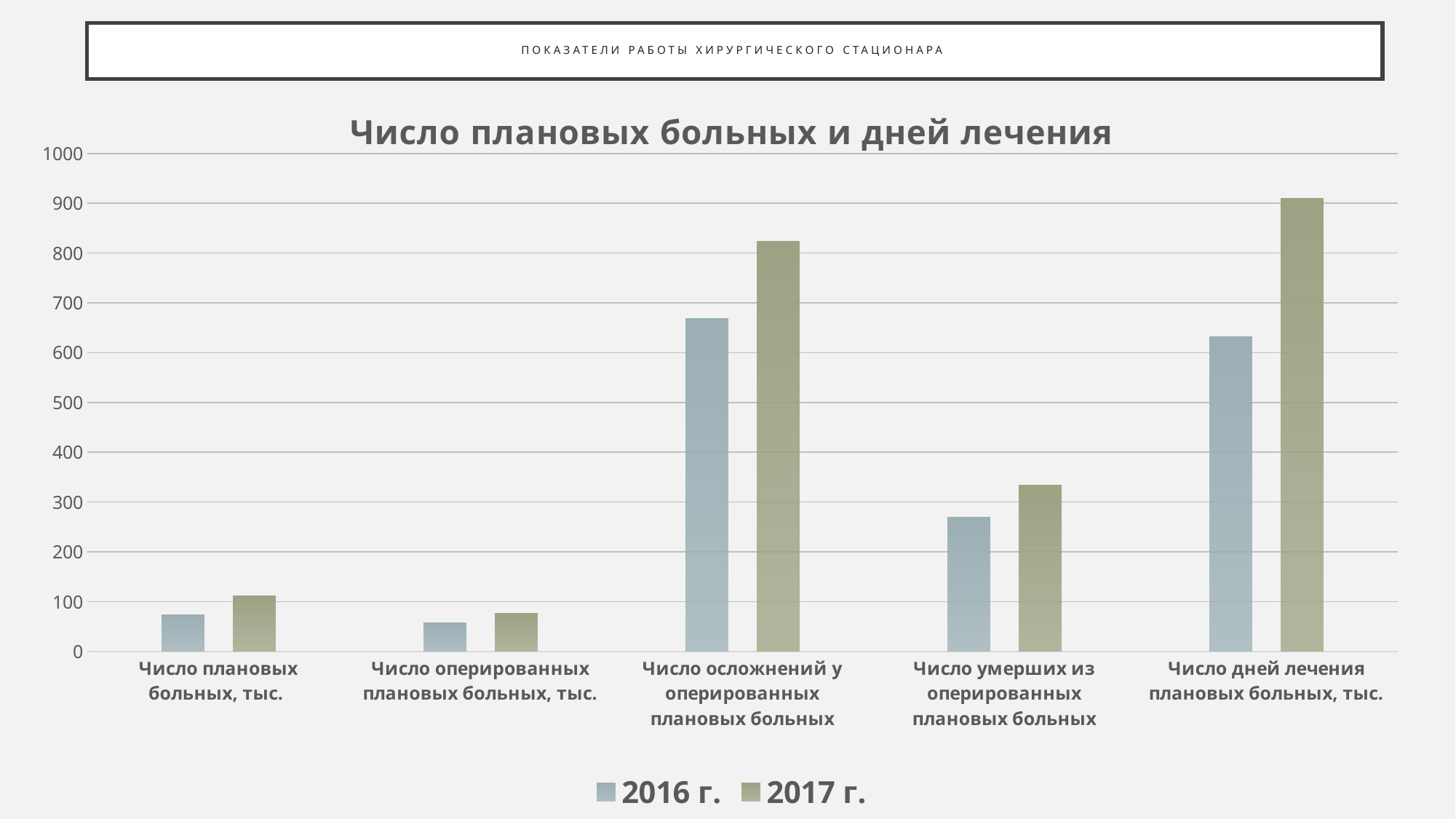
Which is larger for Число осложнений у оперированных плановых больных: the value for 2016 г. or for 2017 г.? 2017 г. Which category has the highest value for 2017 г.? Число дней лечения плановых больных, тыс. What kind of chart is shown on the slide? bar chart Is the value for Число осложнений у оперированных плановых больных in 2016 г. greater or less than 600? greater Which category has the lowest value for 2016 г.? Число оперированных плановых больных, тыс. How many series does the legend list? 2 Is the value for Число дней лечения плановых больных, тыс. in 2017 г. greater or less than 800? greater How many categories are shown on the x axis? 5 Which is larger for Число плановых больных, тыс.: the value for 2016 г. or for 2017 г.? 2017 г. What is the title of the chart? Число плановых больных и дней лечения Which category has the lowest value for 2017 г.? Число оперированных плановых больных, тыс. Is the value for Число умерших из оперированных плановых больных in 2016 г. greater or less than 300? less